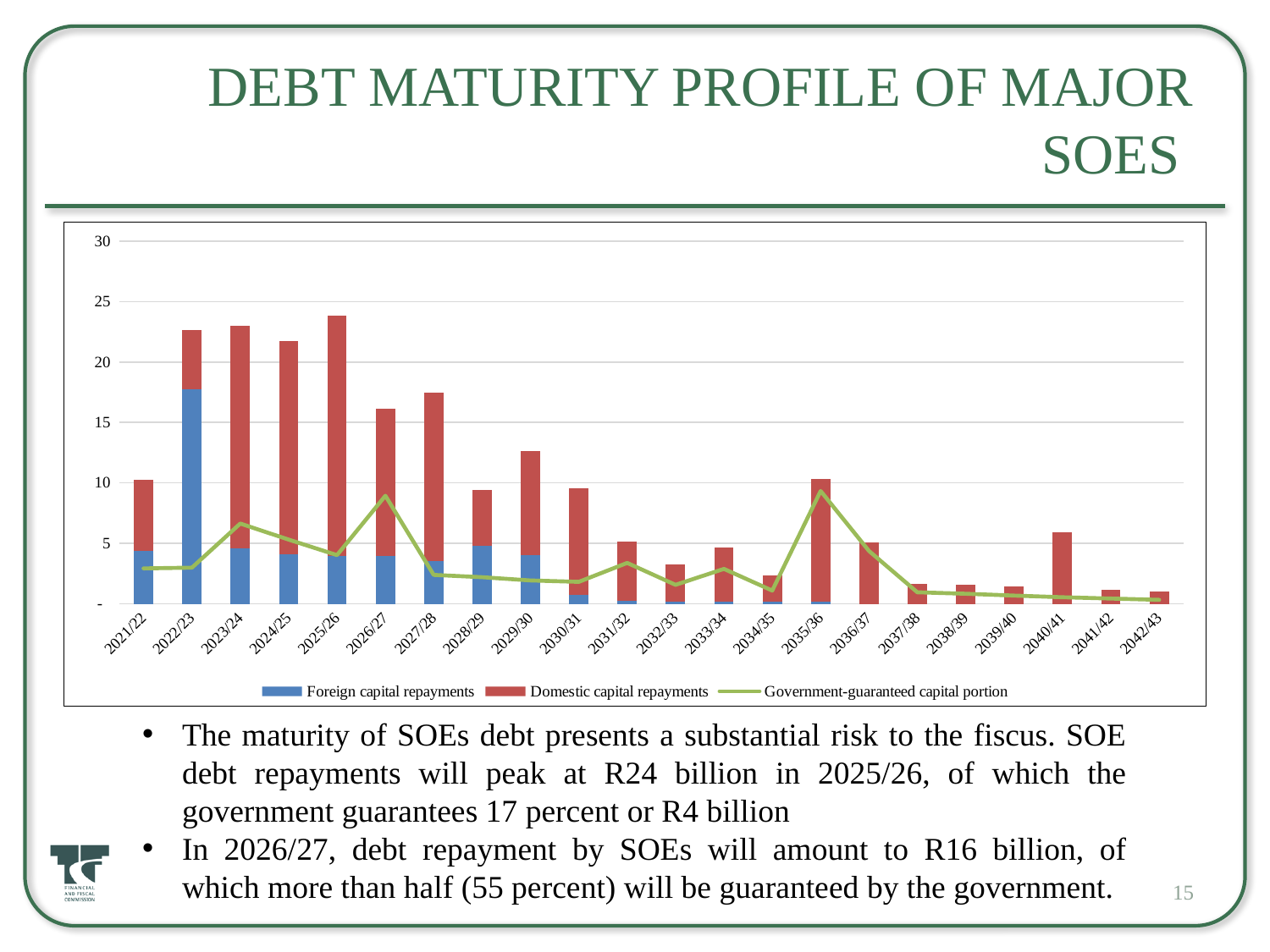
Is the Government-guaranteed capital portion for 2026/27 greater or less than 5? greater Which is larger: foreign capital repayments in 2022/23 or in 2023/24? 2022/23 Is the total stacked bar for 2026/27 greater or less than 15? greater In which year is the total stacked bar (foreign plus domestic capital repayments) highest? 2025/26 How many fiscal years are shown on the x axis of the chart? 22 What kind of chart is shown on the slide? Stacked bar chart with a line Which series is shown as a green line in the chart? Government-guaranteed capital portion Is the Government-guaranteed capital portion for 2021/22 greater or less than 5? less Do the total stacked bars rise or fall from 2035/36 to 2039/40? fall In which year are foreign capital repayments highest? 2022/23 How many series does the chart legend list? 3